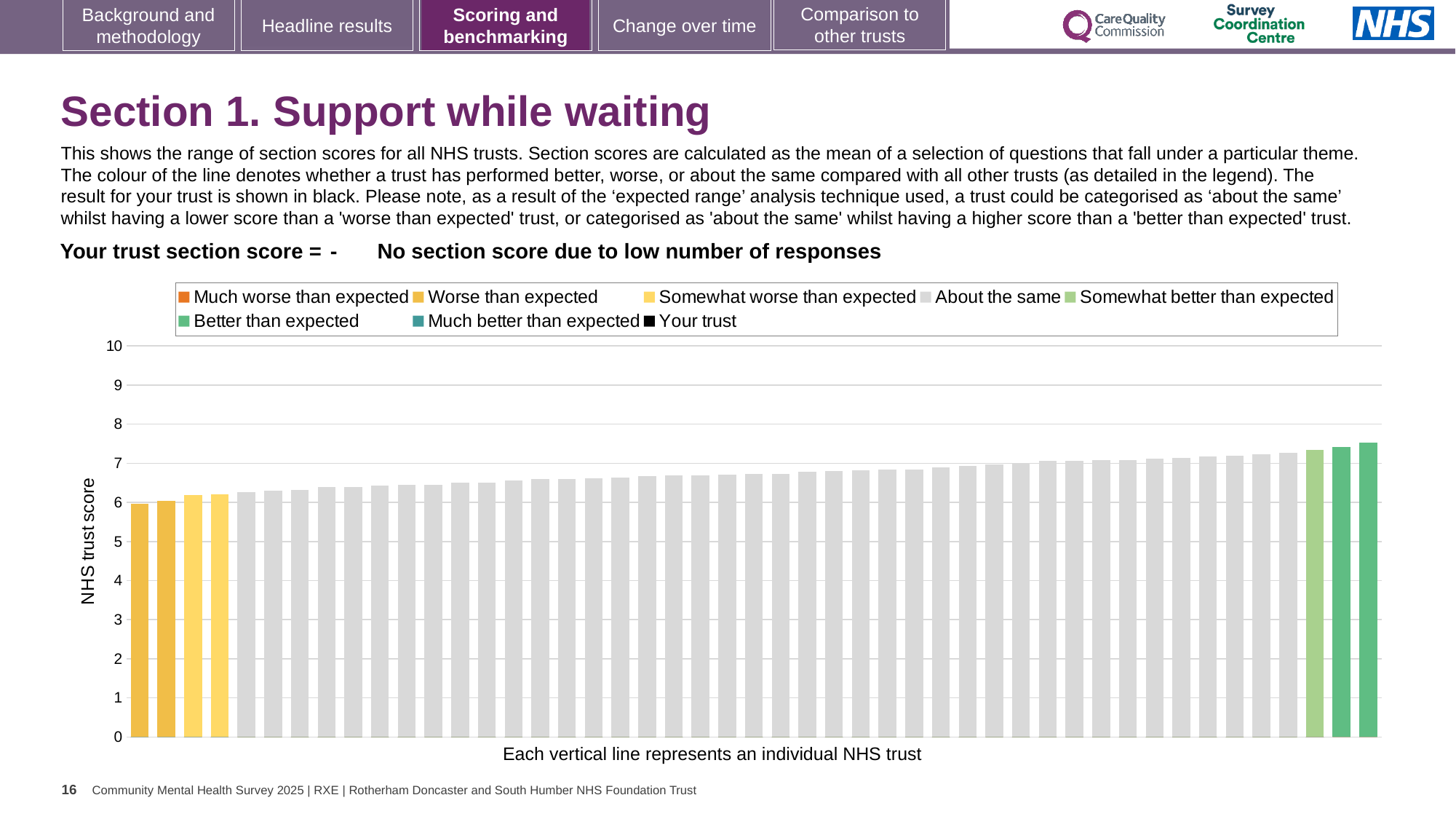
How many bars are coloured as 'Worse than expected' (dark yellow)? 2 Is the value of the shortest bar (leftmost) greater or less than 7? less Is the value of the tallest bar (rightmost) greater or less than 7? greater Which bar is higher: the leftmost bar or the rightmost bar? the rightmost bar Is the value of the tallest bar (rightmost) greater or less than 8? less What is the maximum value shown on the y axis? 10 How many entries does the chart legend list? 8 Do the bar values rise or fall from left to right along the x axis? rise What kind of chart is shown on the slide? bar chart What is the label of the y axis? NHS trust score How many bars are coloured as 'Better than expected' (dark green)? 2